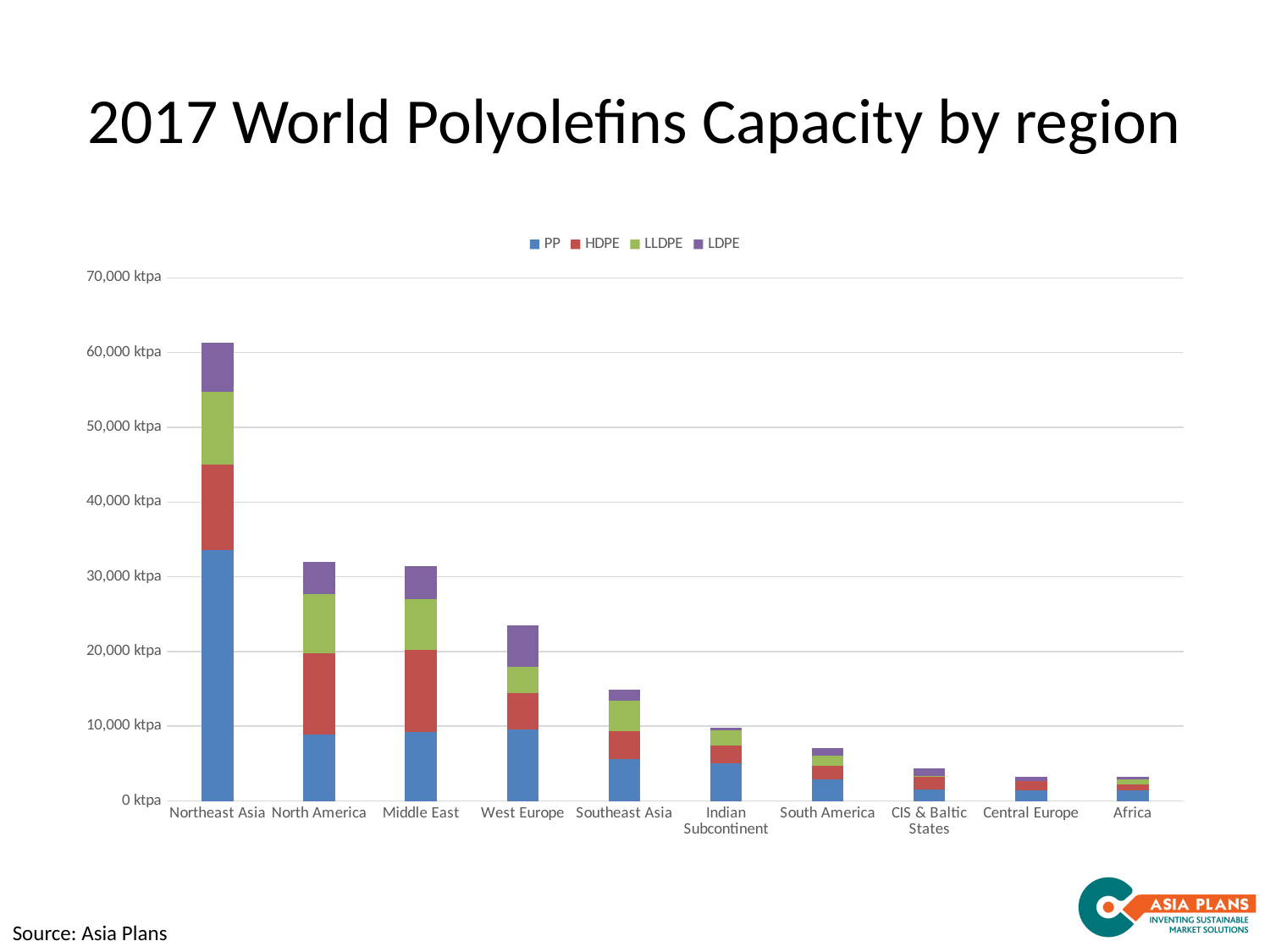
Which has the larger total capacity, West Europe or Southeast Asia? West Europe Is the total capacity for Northeast Asia greater or less than 50,000 ktpa? greater Which has the larger total capacity, Northeast Asia or North America? Northeast Asia Is the total capacity for South America greater or less than 10,000 ktpa? less How many series does the chart legend list? 4 Do the total bar heights generally rise or fall moving from left to right along the x axis? fall Which region has the highest total polyolefins capacity in the chart? Northeast Asia How many regions are shown on the x axis of the chart? 10 Is the total capacity for West Europe greater or less than 20,000 ktpa? greater What kind of chart is shown on the slide? stacked bar chart What is the title of the chart on the slide? 2017 World Polyolefins Capacity by region